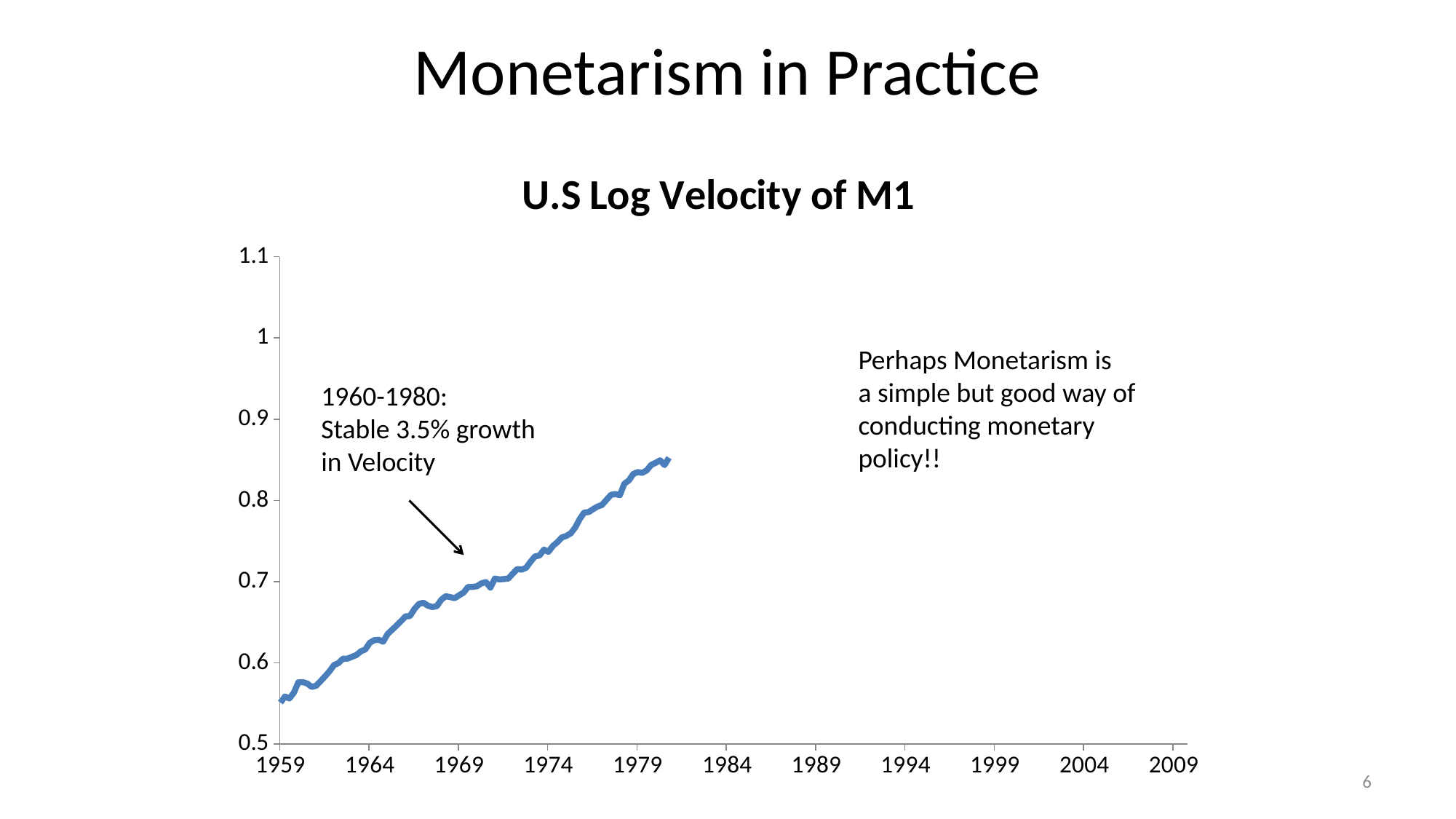
Is the value for 1974 greater or less than 0.7? greater Does the plotted line rise or fall as the years increase from 1959 onward? rise What is the last year labelled on the horizontal axis? 2009 Is the value for 1964 greater or less than 0.6? greater What is the title of the chart? U.S Log Velocity of M1 What kind of chart is shown on the slide? line chart Is the value for 1979 greater or less than 0.8? greater What is the highest value shown on the vertical axis? 1.1 Which year has the larger plotted value, 1959 or 1979? 1979 How many data series are plotted on the chart? 1